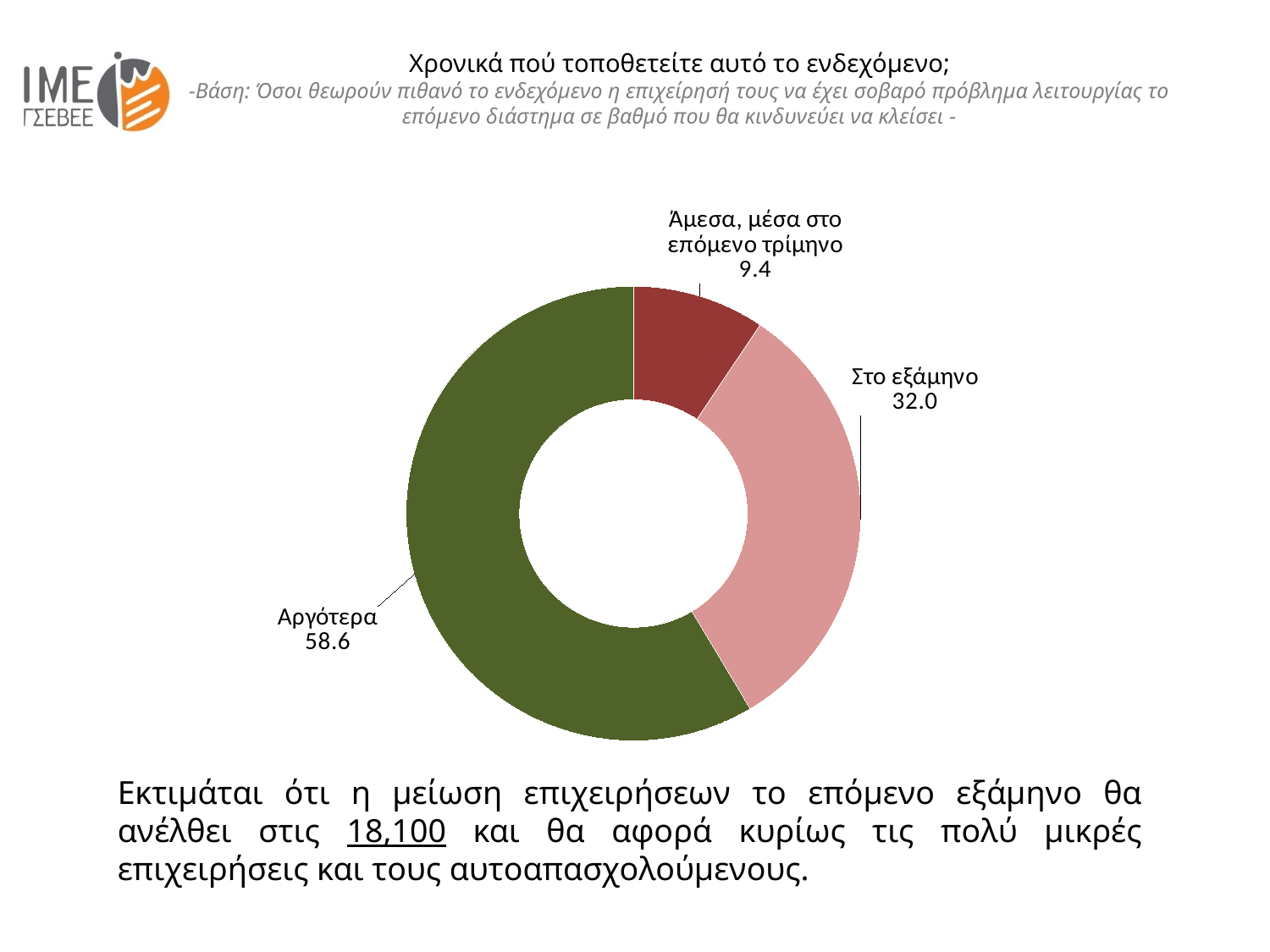
Which is larger, the value for "Στο εξάμηνο" or the value for "Άμεσα, μέσα στο επόμενο τρίμηνο"? Στο εξάμηνο What kind of chart is shown on the slide? Doughnut (pie) chart What value is shown for the slice "Στο εξάμηνο"? 32.0 What value is shown for the slice "Αργότερα"? 58.6 What is the difference between the values for "Αργότερα" and "Στο εξάμηνο"? 26.6 Which category has the largest slice in the chart? Αργότερα What is the title of the chart on the slide? Χρονικά πού τοποθετείτε αυτό το ενδεχόμενο; How many categories (slices) does the chart show? 3 Which category has the smallest slice in the chart? Άμεσα, μέσα στο επόμενο τρίμηνο What share of the chart does the slice "Αργότερα" represent? 58.6 What value is shown for the slice "Άμεσα, μέσα στο επόμενο τρίμηνο"? 9.4 What is the difference between the values for "Στο εξάμηνο" and "Άμεσα, μέσα στο επόμενο τρίμηνο"? 22.6